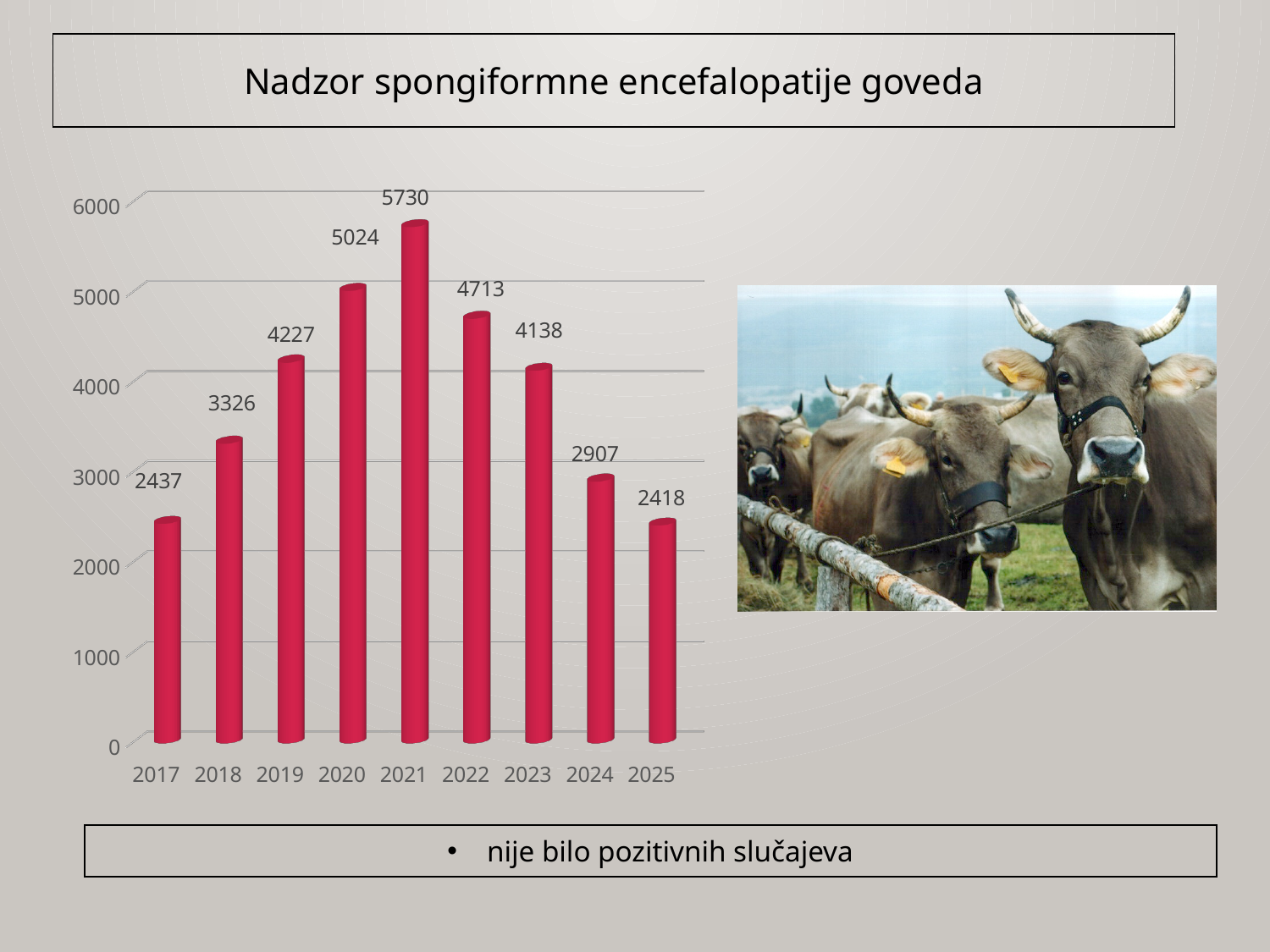
Which year has the lowest value? 2025 Do the values rise or fall from 2021 to 2025? fall Which is larger, the value for 2019 or the value for 2023? 2023 What is the difference between the values for 2021 and 2020? 706 How many years are shown on the x axis? 9 Which year has the highest value? 2021 Is the value for 2018 greater or less than 3000? greater What is the difference between the values for 2022 and 2023? 575 What is the value for 2024? 2907 What is the value for 2021? 5730 What is the value for 2017? 2437 What kind of chart is shown on the slide? bar chart